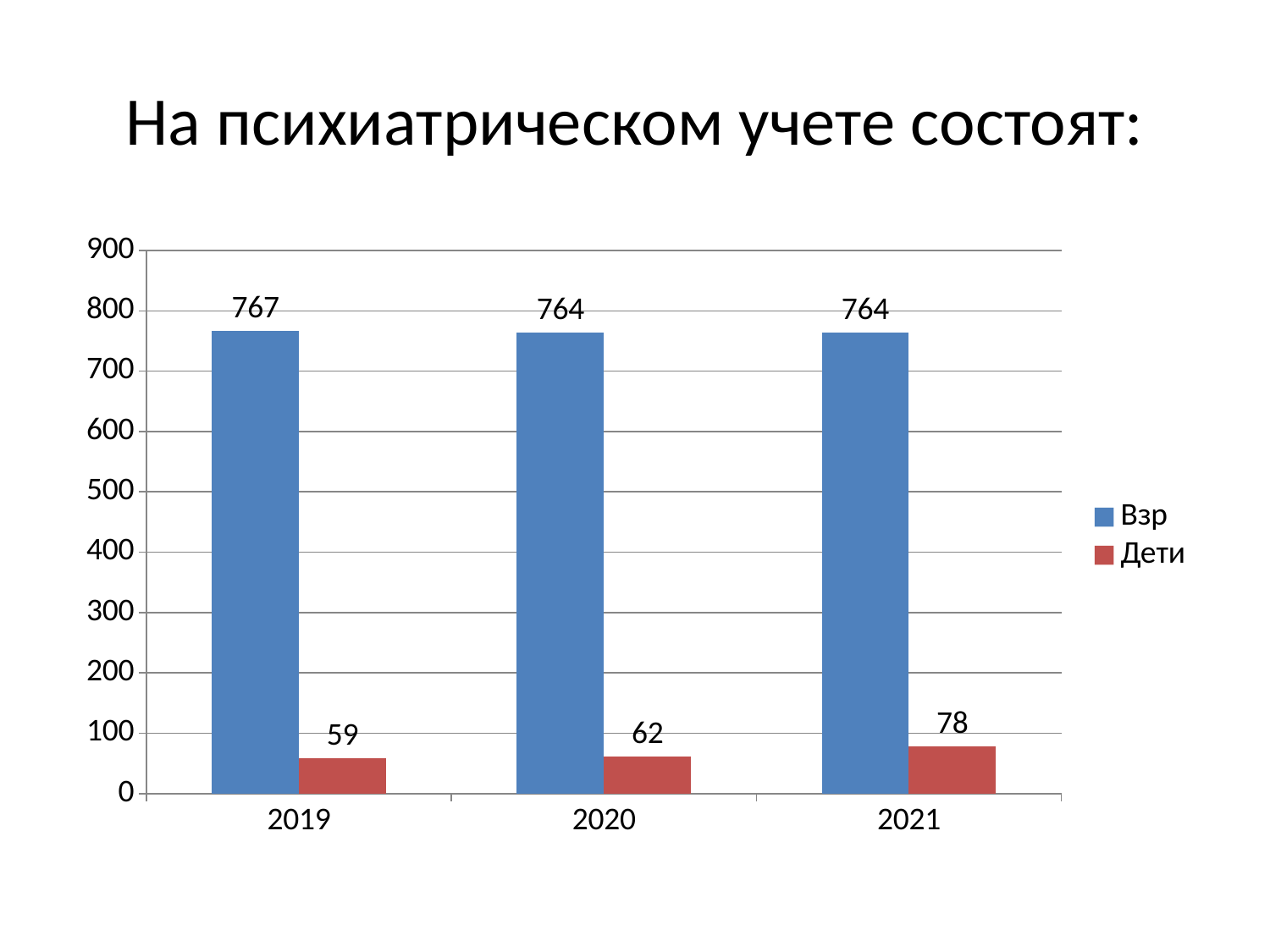
How many years are shown on the x axis? 3 In which year is the Дети value lowest? 2019 What kind of chart is shown on the slide? bar chart In which year is the Дети value highest? 2021 Is the value for Взр in 2020 greater or less than 700? greater What is the difference between the Взр and Дети values in 2021? 686 Which is larger: the Взр value in 2019 or the Взр value in 2020? 2019 What is the value for Дети in 2020? 62 What is the value for Дети in 2021? 78 What is the value for Взр in 2019? 767 What is the difference between the Дети values in 2021 and 2019? 19 How many series does the legend list? 2